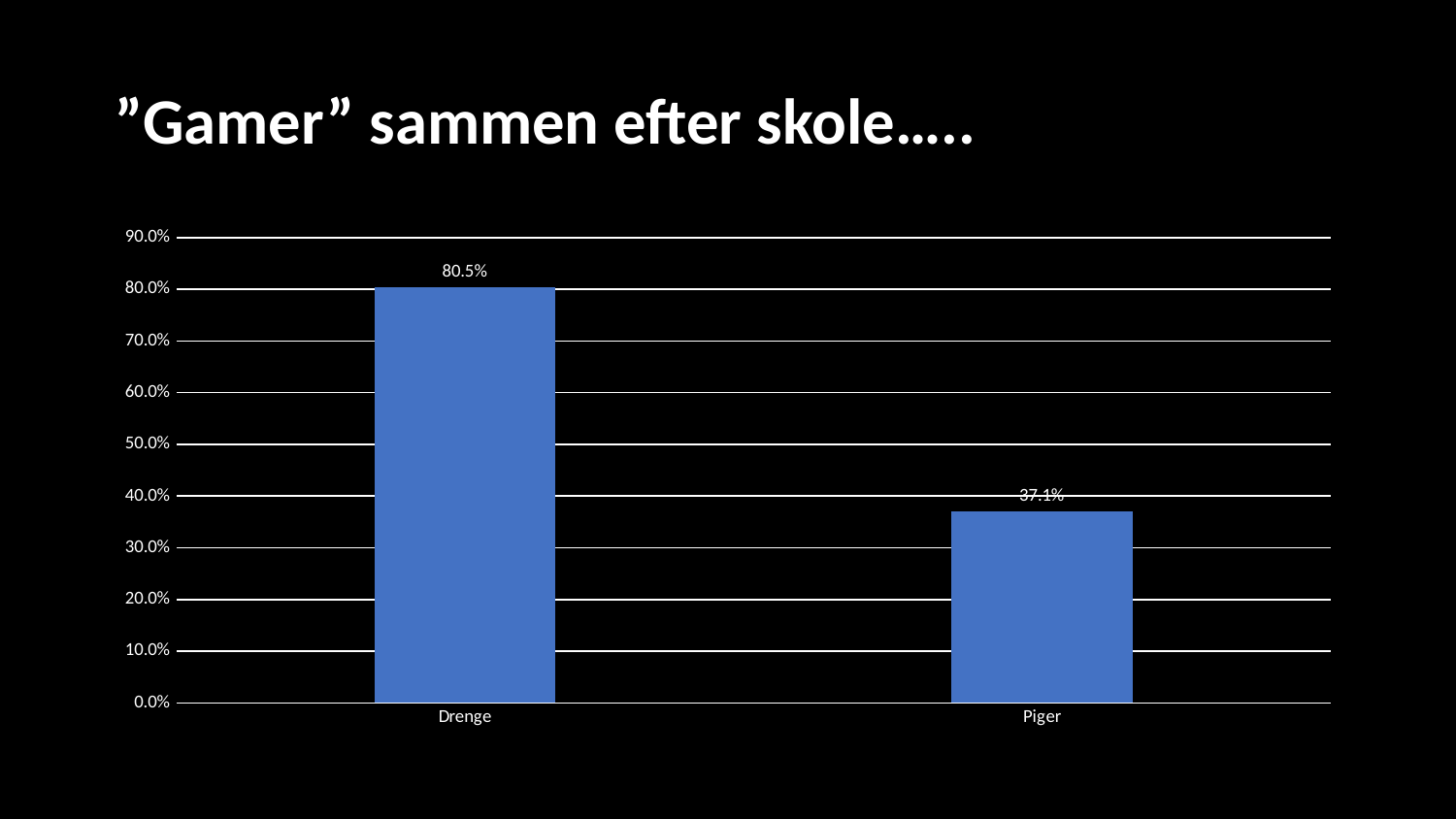
Is the value for Piger greater or less than 40.0%? less How many categories are shown on the x axis? 2 Is the value for Drenge greater or less than 70.0%? greater Which category has the lowest value? Piger Which is larger, the value for Drenge or the value for Piger? Drenge What is the title of the slide? "Gamer" sammen efter skole….. What is the difference between the values for Drenge and Piger? 43.4% What is the value for Piger? 37.1% What is the value for Drenge? 80.5% Which category has the highest value? Drenge What is the highest value shown on the y axis? 90.0% What kind of chart is shown on the slide? Bar chart